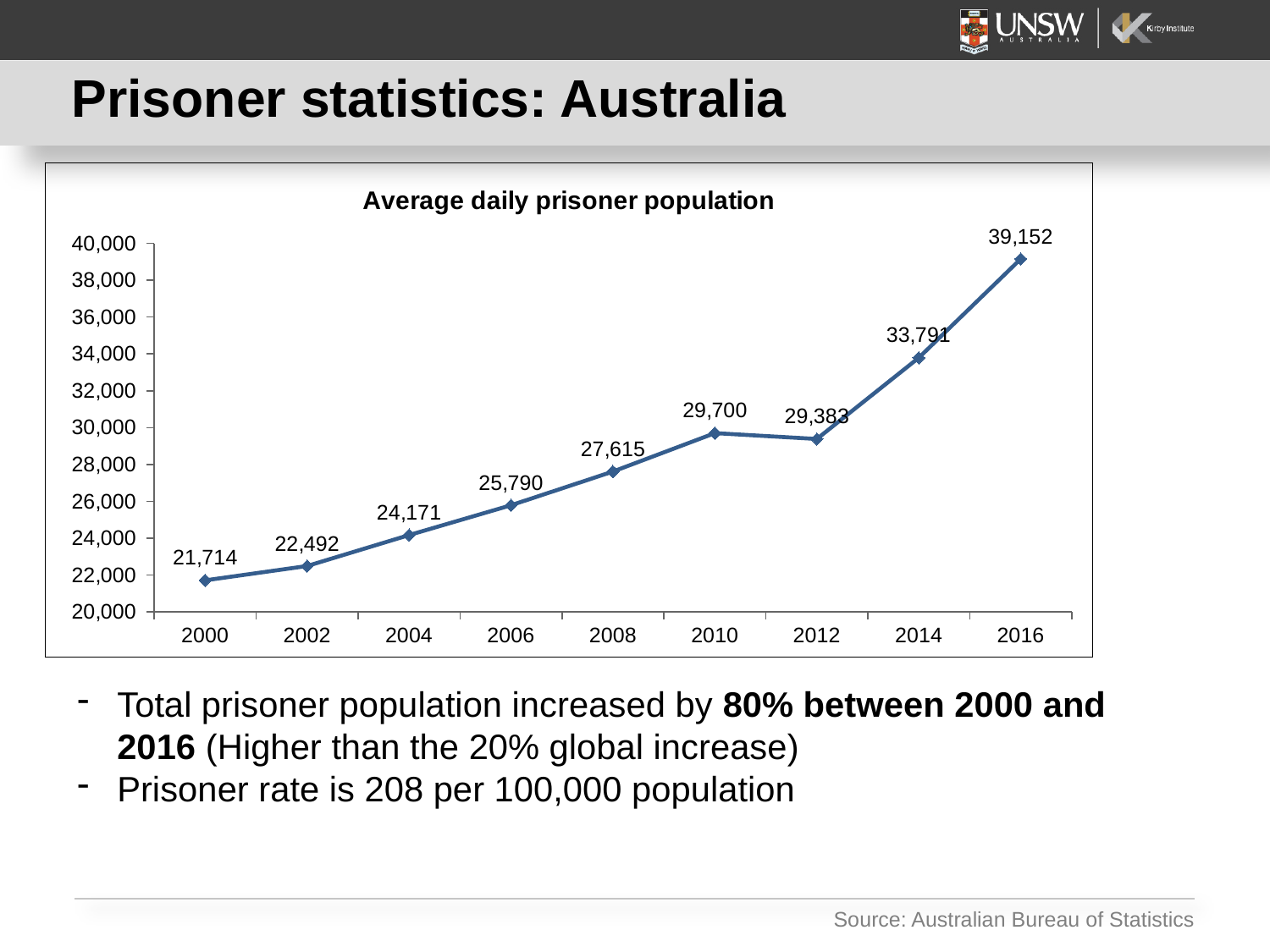
What is the average daily prisoner population in 2000? 21,714 What is the average daily prisoner population in 2014? 33,791 Which year has a larger average daily prisoner population, 2010 or 2012? 2010 Which year has the lowest average daily prisoner population? 2000 By how much did the average daily prisoner population fall from 2010 to 2012? 317 Overall, does the average daily prisoner population rise or fall from 2000 to 2016? Rise What type of chart is shown on the slide? Line chart What is the title of the chart? Average daily prisoner population How many data points are plotted on the chart? 9 What is the difference between the average daily prisoner population in 2016 and in 2000? 17,438 Which year has the highest average daily prisoner population? 2016 What is the average daily prisoner population in 2008? 27,615